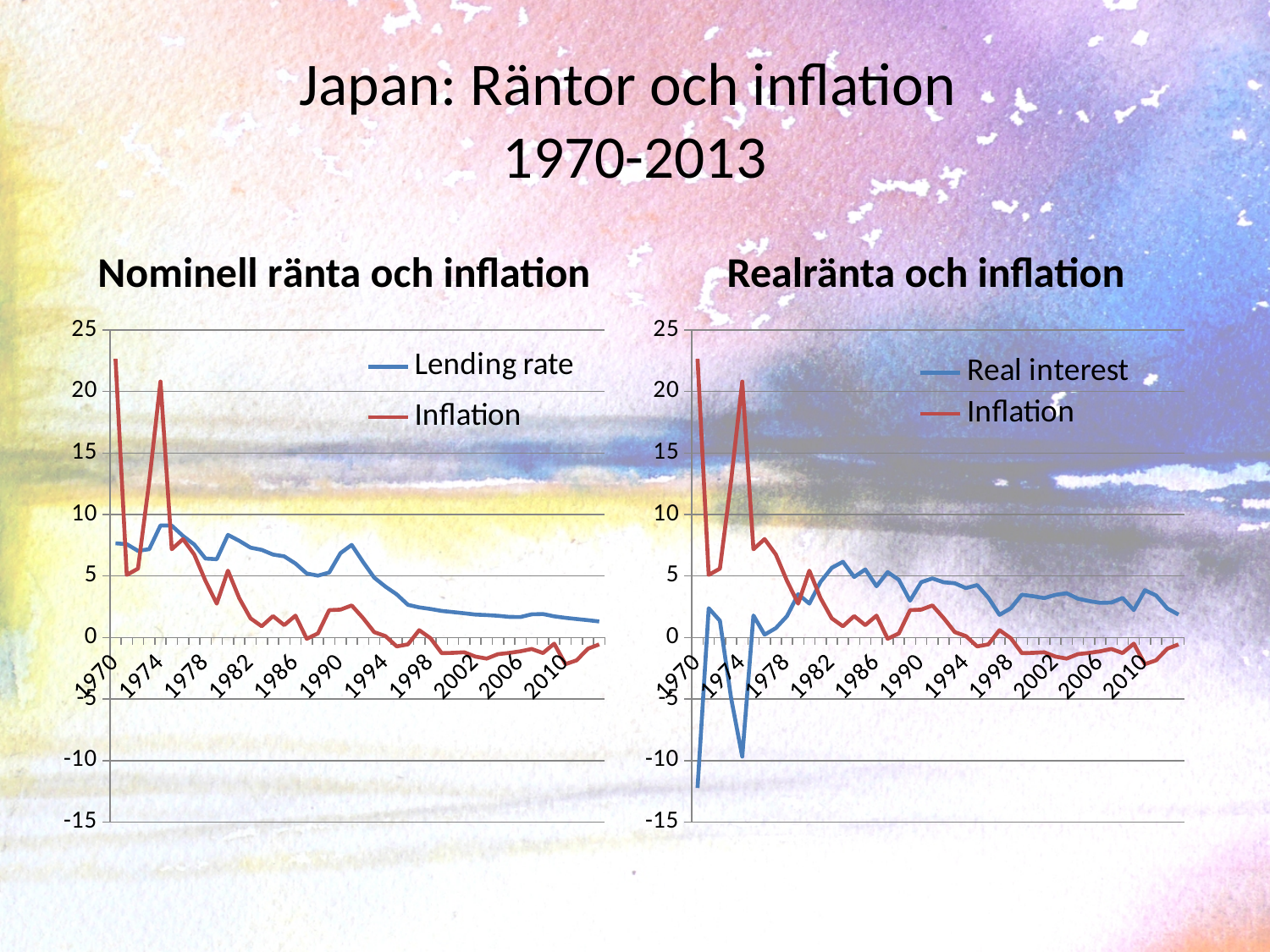
In the chart titled "Nominell ränta och inflation", which two series are listed in the legend? Lending rate and Inflation In the chart titled "Nominell ränta och inflation", is the Inflation value for 1970 greater or less than 20? greater In the chart titled "Nominell ränta och inflation", which is larger in 1970, the Lending rate or Inflation? Inflation In the chart titled "Realränta och inflation", which is larger in 1970, Real interest or Inflation? Inflation In the chart titled "Realränta och inflation", what colour is the Real interest line? blue In the chart titled "Realränta och inflation", is the Real interest value for 1970 greater or less than -10? less What kind of chart is the chart titled "Nominell ränta och inflation"? line chart In the chart titled "Nominell ränta och inflation", is the Lending rate value for 1970 greater or less than 10? less How many series does the legend of the chart titled "Realränta och inflation" list? 2 In the chart titled "Nominell ränta och inflation", does the Lending rate generally rise or fall from 1970 to 2013? fall